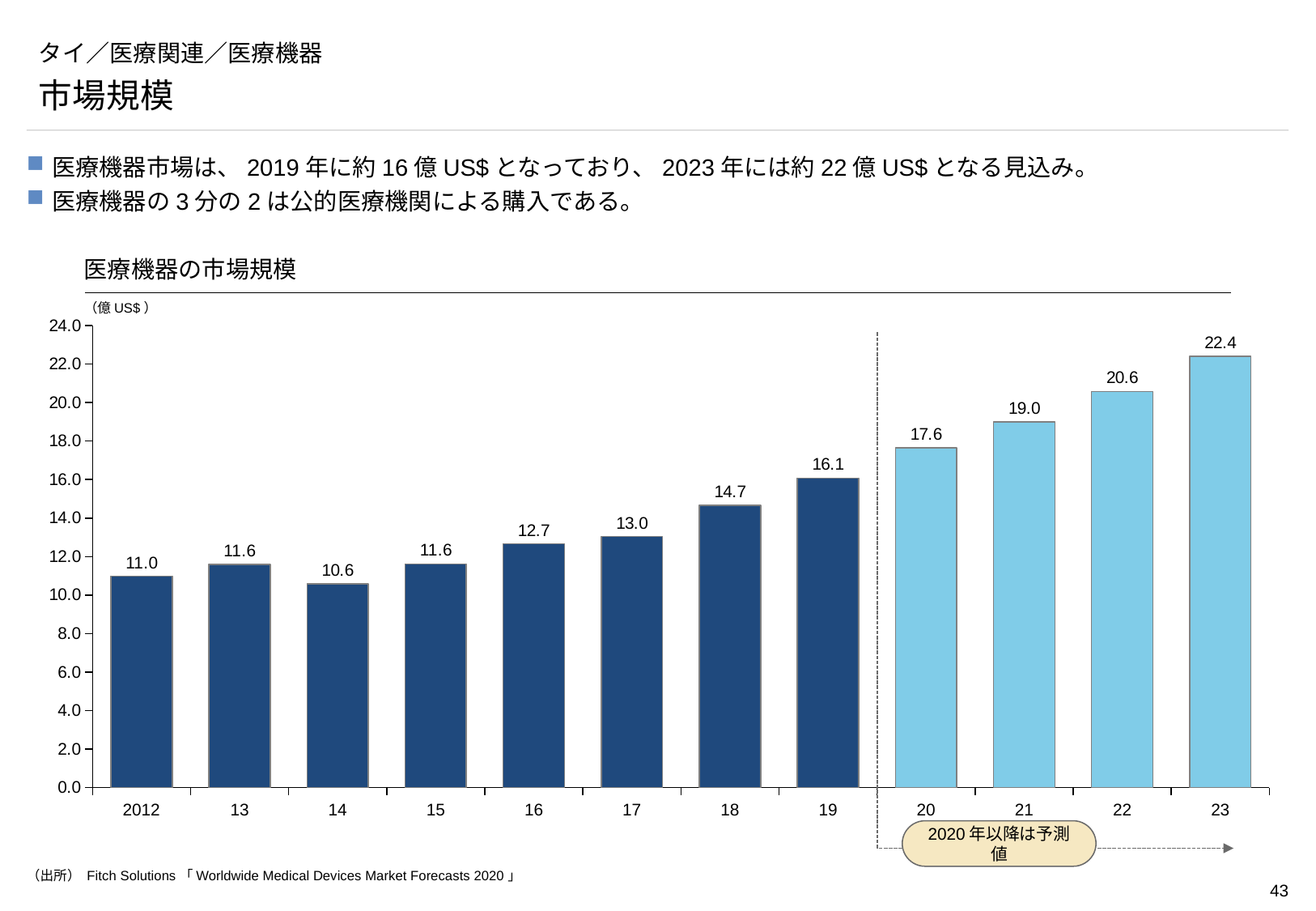
What is the difference between the values for 2023 and 2019? 6.3 What kind of chart is shown on the slide? bar chart What is the value for 2019 in the 医療機器の市場規模 chart? 16.1 What is the value for 2023 in the chart? 22.4 What is the value for 2014 in the chart? 10.6 Which is larger, the value for 2018 or the value for 2017? 2018 Which year has the highest value in the chart? 23 How many years are shown on the x axis of the chart? 12 What unit is shown on the y axis of the chart? 億US$ Is the value for 2021 greater or less than 18.0? greater Do the values generally rise or fall from 2014 to 2023? rise Which year has the lowest value in the chart? 14